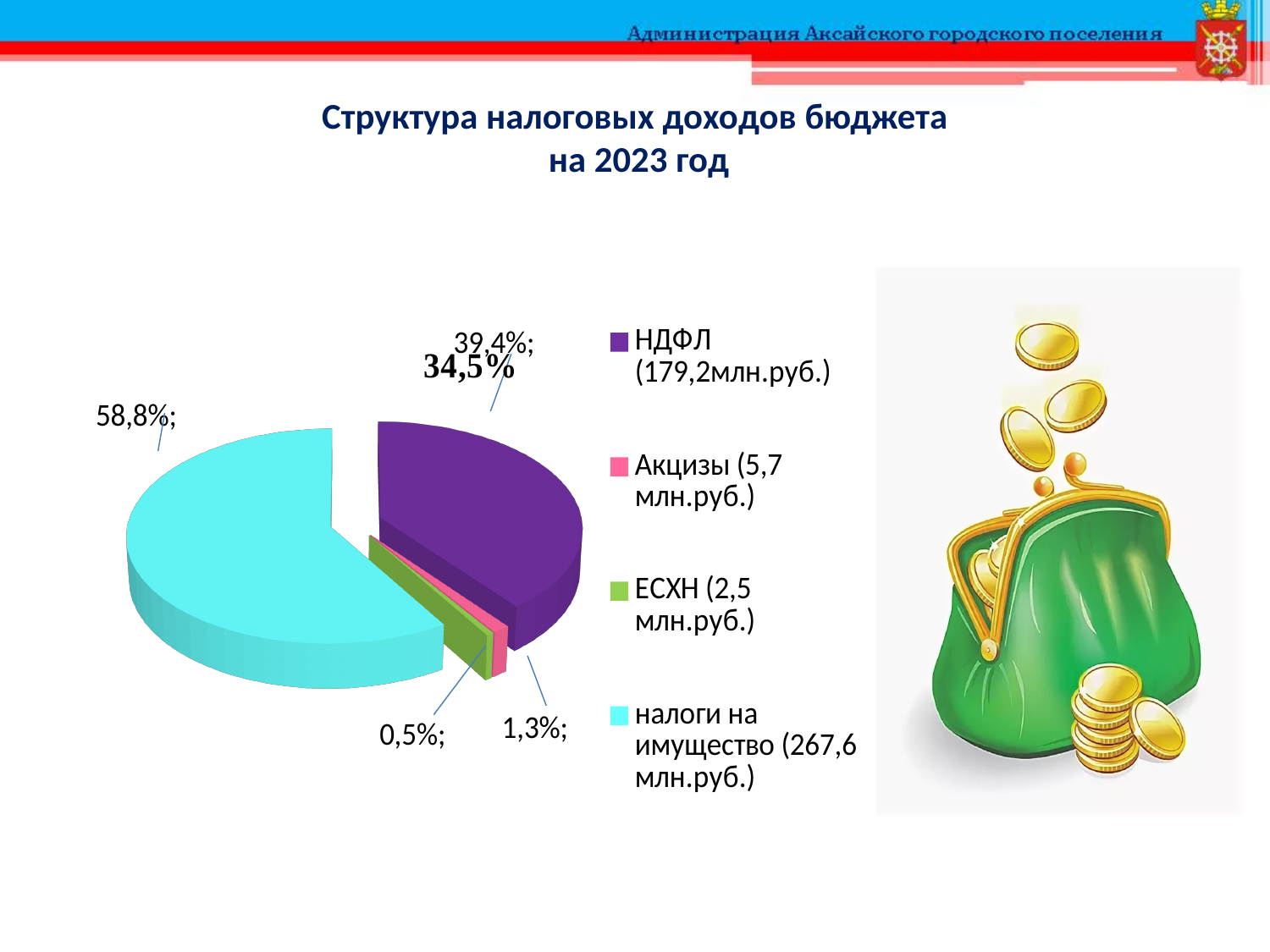
What is the difference in percentage points between the налоги на имущество slice (58,8%) and the Акцизы slice (1,3%)? 57,5% What share of the pie is labelled for налоги на имущество? 58,8% Which category has the largest slice of the pie? налоги на имущество Which slice is larger, Акцизы or ЕСХН? Акцизы According to the legend, what amount in млн.руб. is given for налоги на имущество? 267,6 млн.руб. What is the title of the chart on the slide? Структура налоговых доходов бюджета на 2023 год According to the legend, what amount in млн.руб. is given for НДФЛ? 179,2 млн.руб. What share of the pie is labelled for ЕСХН? 0,5% What share of the pie is labelled for Акцизы? 1,3% What kind of chart is shown on the slide? Pie chart How many categories does the pie chart have? 4 Which category has the smallest slice of the pie? ЕСХН